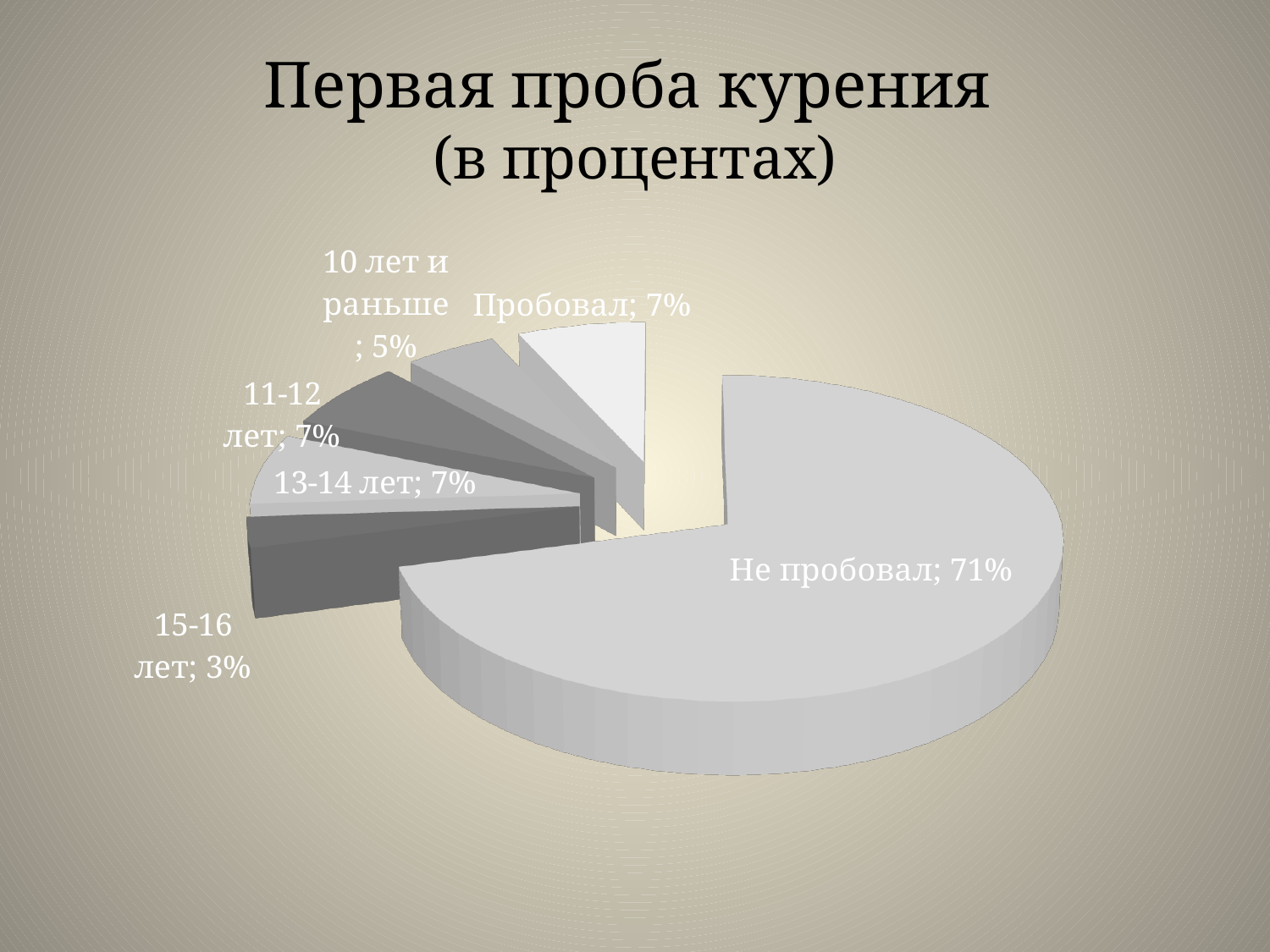
Which is larger, the share for "10 лет и раньше" or the share for "11-12 лет"? 11-12 лет Which category has the largest share of the pie? Не пробовал What is the title of the chart? Первая проба курения (в процентах) What is the difference between the shares for "10 лет и раньше" and "15-16 лет"? 2% What percentage is shown for "Не пробовал"? 71% What is the difference between the shares for "Не пробовал" and "Пробовал"? 64% What kind of chart is shown on the slide? pie chart What percentage is shown for "13-14 лет"? 7% How many slices does the pie chart have? 6 What percentage is shown for "10 лет и раньше"? 5% What percentage is shown for "15-16 лет"? 3% Which category has the smallest share of the pie? 15-16 лет